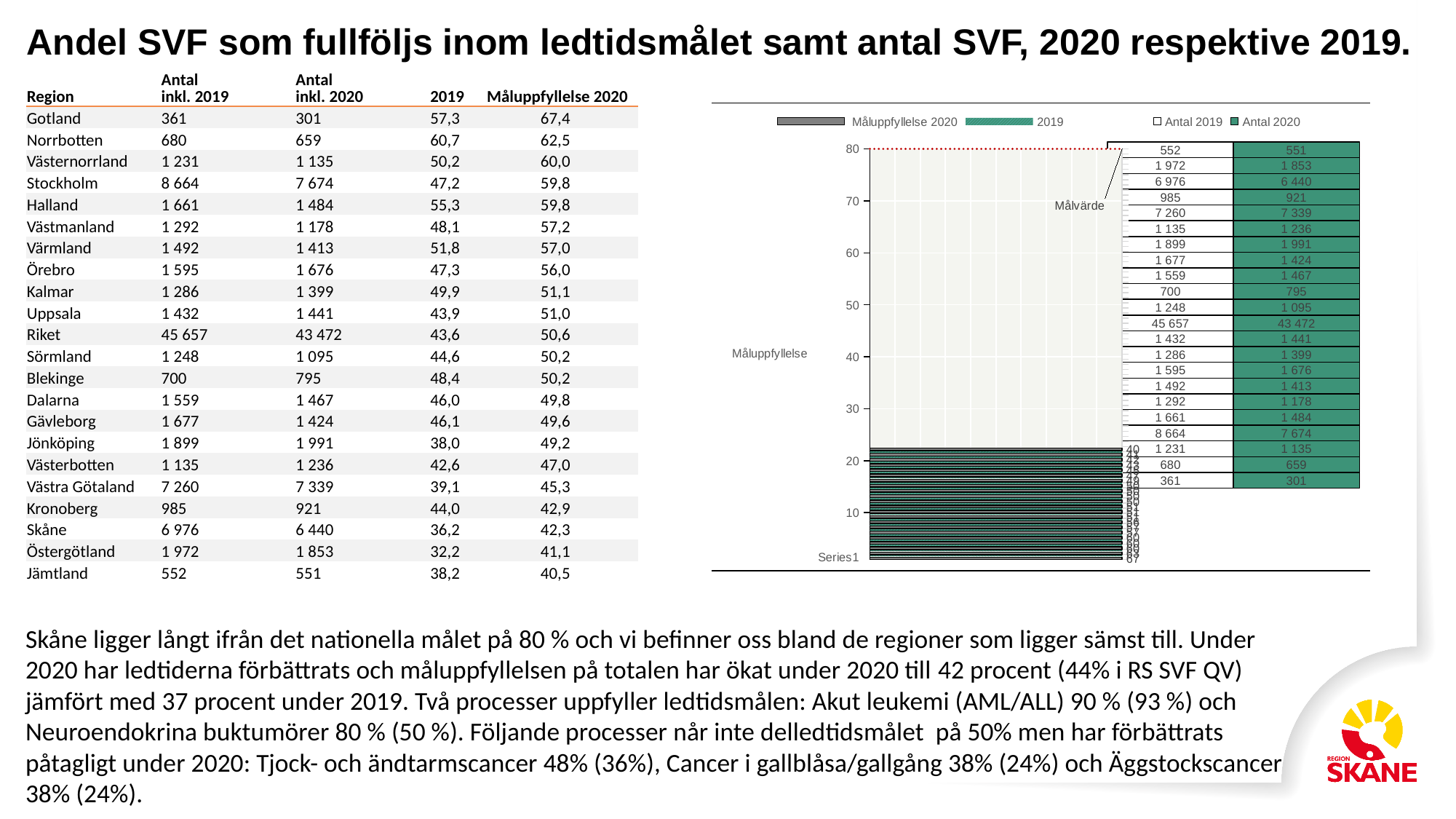
What is the label on the chart's y axis? Måluppfyllelse In the chart's data table, what is the difference between Antal 2019 and Antal 2020 in the first row? 1 In the chart's data table, what is the largest value in the Antal 2019 column? 45 657 In the chart's data table, what is the smallest value in the Antal 2020 column? 301 In the chart's data table, which is larger in the first row: Antal 2019 or Antal 2020? Antal 2019 What is the highest tick value shown on the chart's y axis? 80 What value does the Målvärde line on the chart mark on the y axis? 80 In the chart's data table, what is the Antal 2020 value in the first row? 551 What kind of chart is shown on the right of the slide? bar chart In the chart's data table, what is the largest value in the Antal 2020 column? 43 472 How many series does the chart's legend list? 4 In the chart's data table, what is the Antal 2019 value in the first row? 552